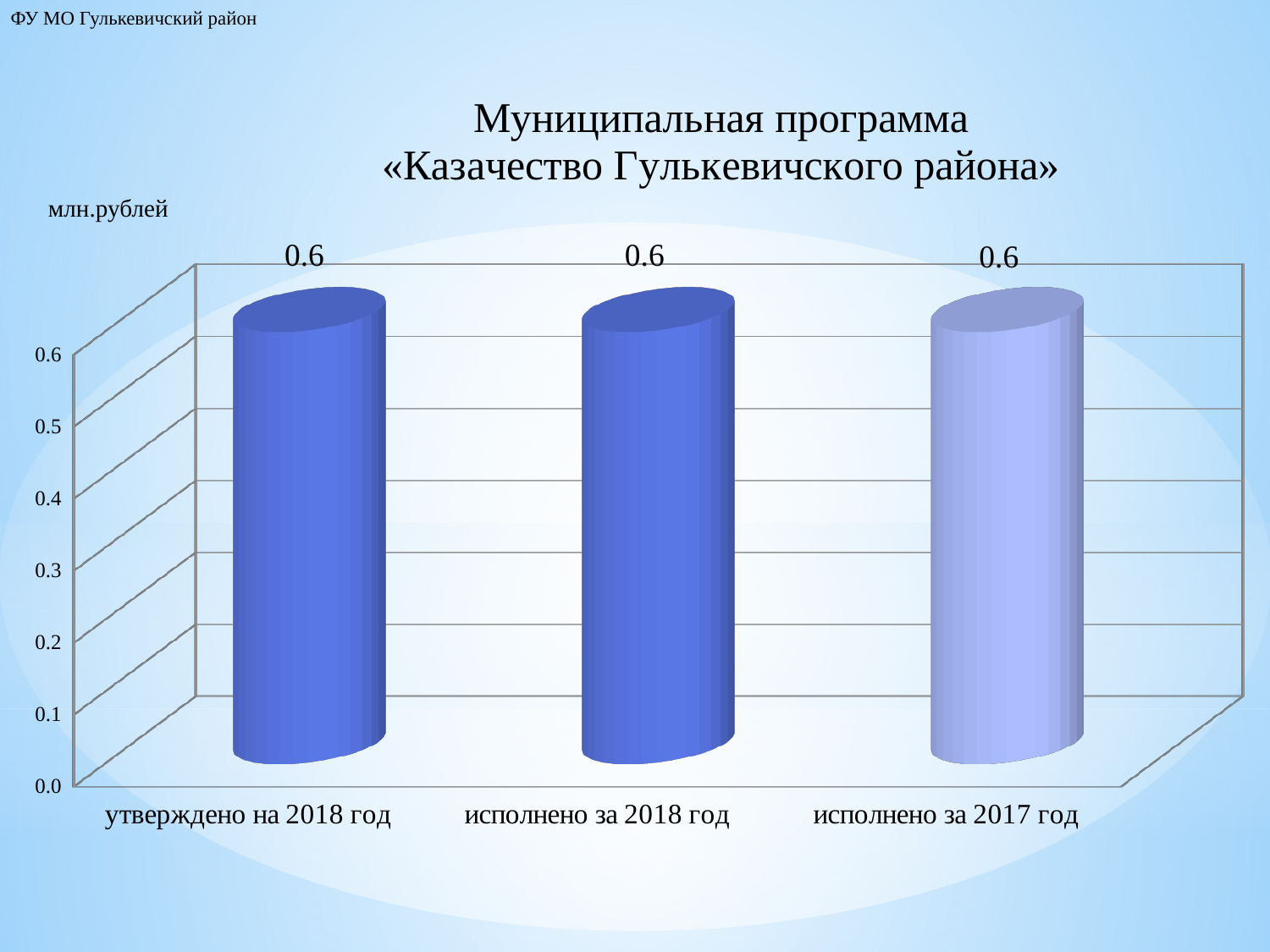
What is the difference between the values for «утверждено на 2018 год» and «исполнено за 2018 год»? 0 What is the value for «исполнено за 2018 год»? 0.6 Is the value for «исполнено за 2017 год» greater or less than 0.5? greater What is the title of the chart? Муниципальная программа «Казачество Гулькевичского района» What kind of chart is shown on the slide? bar chart In what units are the values on the chart given? млн.рублей How many categories are shown on the chart? 3 Do the values rise, fall or stay the same across the categories from left to right? stay the same Is the value for «утверждено на 2018 год» greater or less than 0.3? greater What is the value for «утверждено на 2018 год»? 0.6 What is the difference between the values for «исполнено за 2018 год» and «исполнено за 2017 год»? 0 What is the value for «исполнено за 2017 год»? 0.6